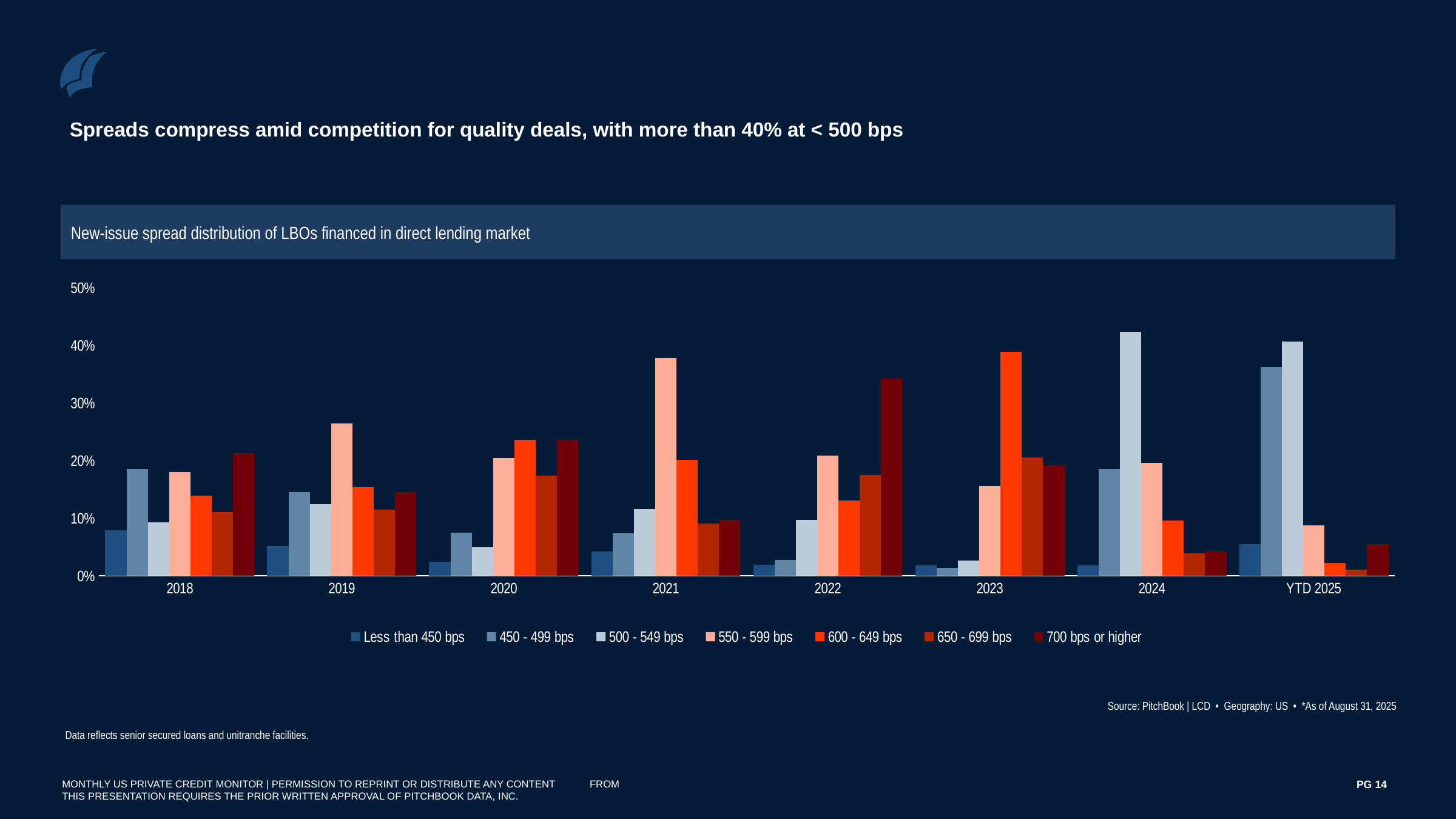
Is the value for 500 - 549 bps in 2024 greater or less than 40%? greater Does the share for 700 bps or higher rise or fall from 2022 to YTD 2025? fall What kind of chart is shown on the slide? bar chart In 2018, which is larger: the 450 - 499 bps bar or the 500 - 549 bps bar? 450 - 499 bps How many series does the legend list? 7 Is the value for 550 - 599 bps in YTD 2025 greater or less than 10%? less What is the title of the chart? New-issue spread distribution of LBOs financed in direct lending market In 2024, which spread bucket has the highest share? 500 - 549 bps How many year categories are shown on the x axis? 8 In 2021, which spread bucket has the highest share? 550 - 599 bps Is the value for 700 bps or higher in 2022 greater or less than 30%? greater In 2023, which spread bucket has the highest share? 600 - 649 bps